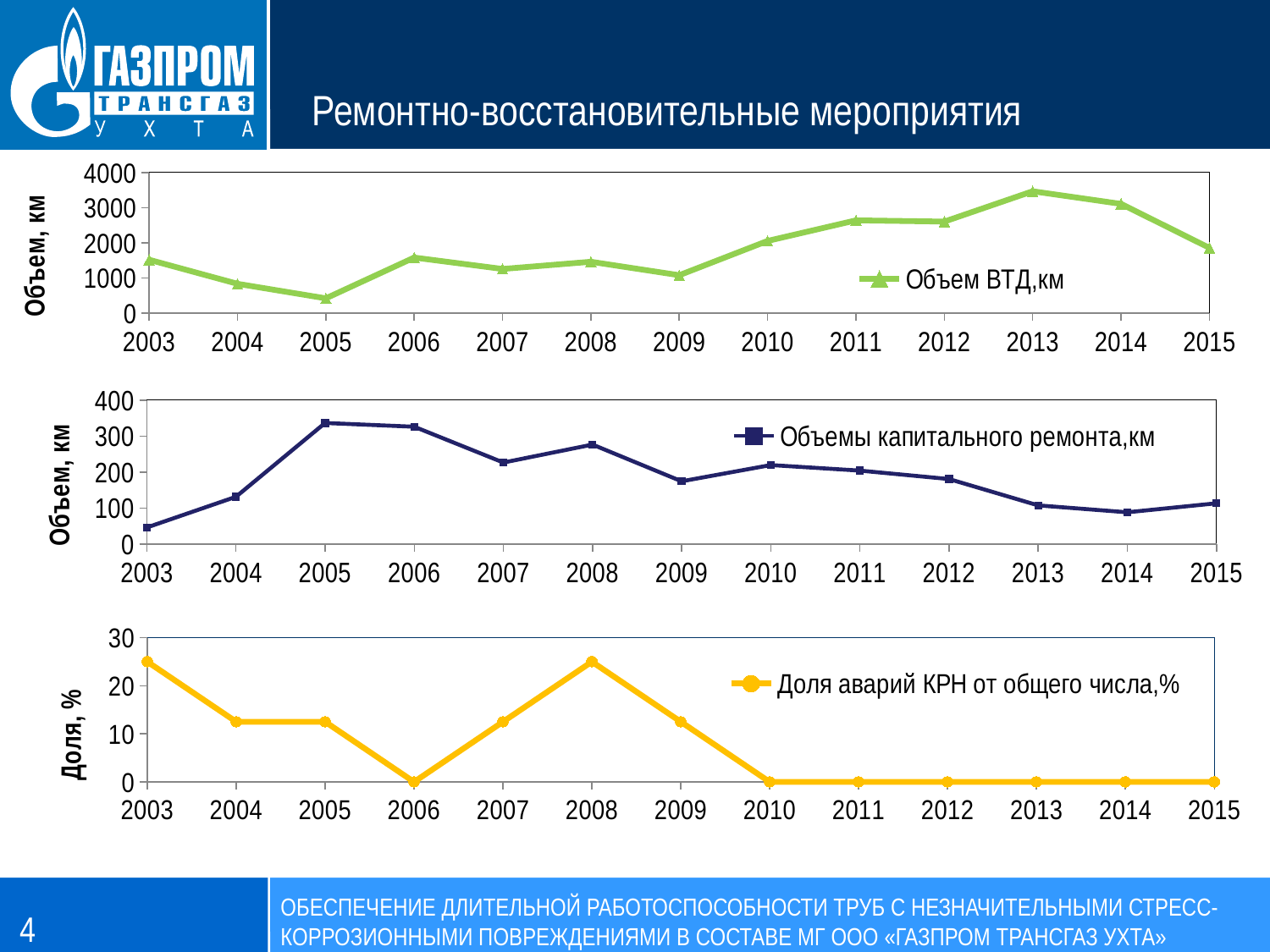
In the top chart (Объем ВТД,км), is the value for 2005 greater or less than 1000? less In the top chart (Объем ВТД,км), which year has the lowest value? 2005 In the bottom chart (Доля аварий КРН от общего числа,%), do the values rise or fall from 2003 to 2006? fall In the middle chart (Объемы капитального ремонта,км), which year has the lowest value? 2003 What kind of chart is the top chart (Объем ВТД,км)? line chart In the middle chart (Объемы капитального ремонта,км), is the value for 2005 greater or less than 300? greater How many series does the legend of the middle chart list? 1 In the bottom chart (Доля аварий КРН от общего числа,%), what is the value for 2010? 0 In the middle chart (Объемы капитального ремонта,км), which year has the larger value, 2008 or 2009? 2008 In the top chart (Объем ВТД,км), is the value for 2013 greater or less than 3000? greater In the top chart (Объем ВТД,км), which year has the highest value? 2013 How many years are shown on the x axis of the top chart (Объем ВТД,км)? 13